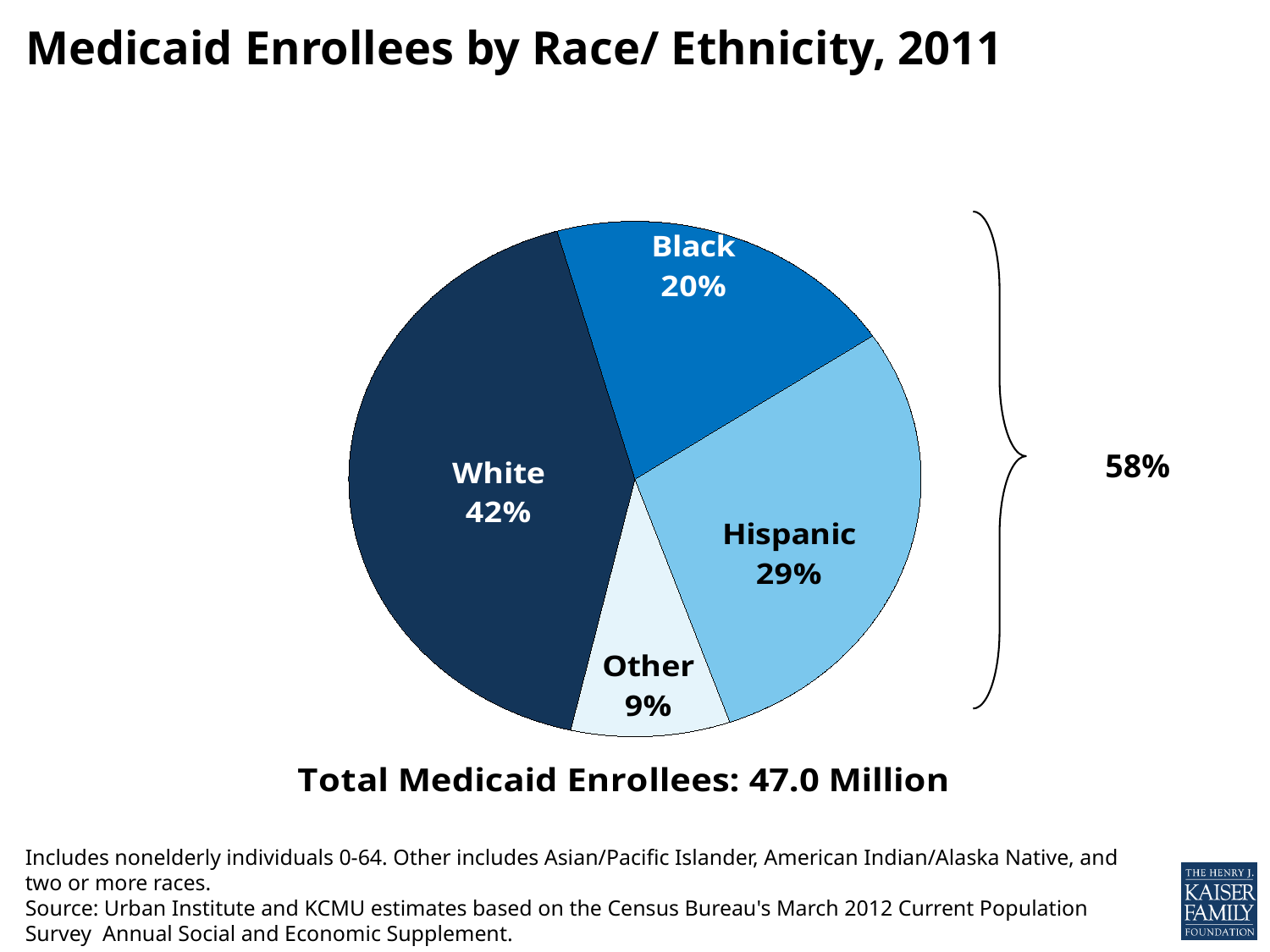
How many race/ethnicity categories are shown in the pie chart? 4 What share of Medicaid enrollees is Hispanic? 29% What share of Medicaid enrollees falls in the Other category? 9% What combined share is indicated by the bracket grouping the Black, Hispanic and Other slices? 58% Which is larger, the Hispanic share or the Black share? Hispanic What kind of chart is shown on the slide? Pie chart What share of Medicaid enrollees is Black? 20% Which race/ethnicity group has the smallest share of Medicaid enrollees? Other Which race/ethnicity group has the largest share of Medicaid enrollees? White What is the total number of Medicaid enrollees stated below the chart? 47.0 Million What share of Medicaid enrollees is White? 42% What is the difference in percentage points between the White and Hispanic shares? 13 percentage points